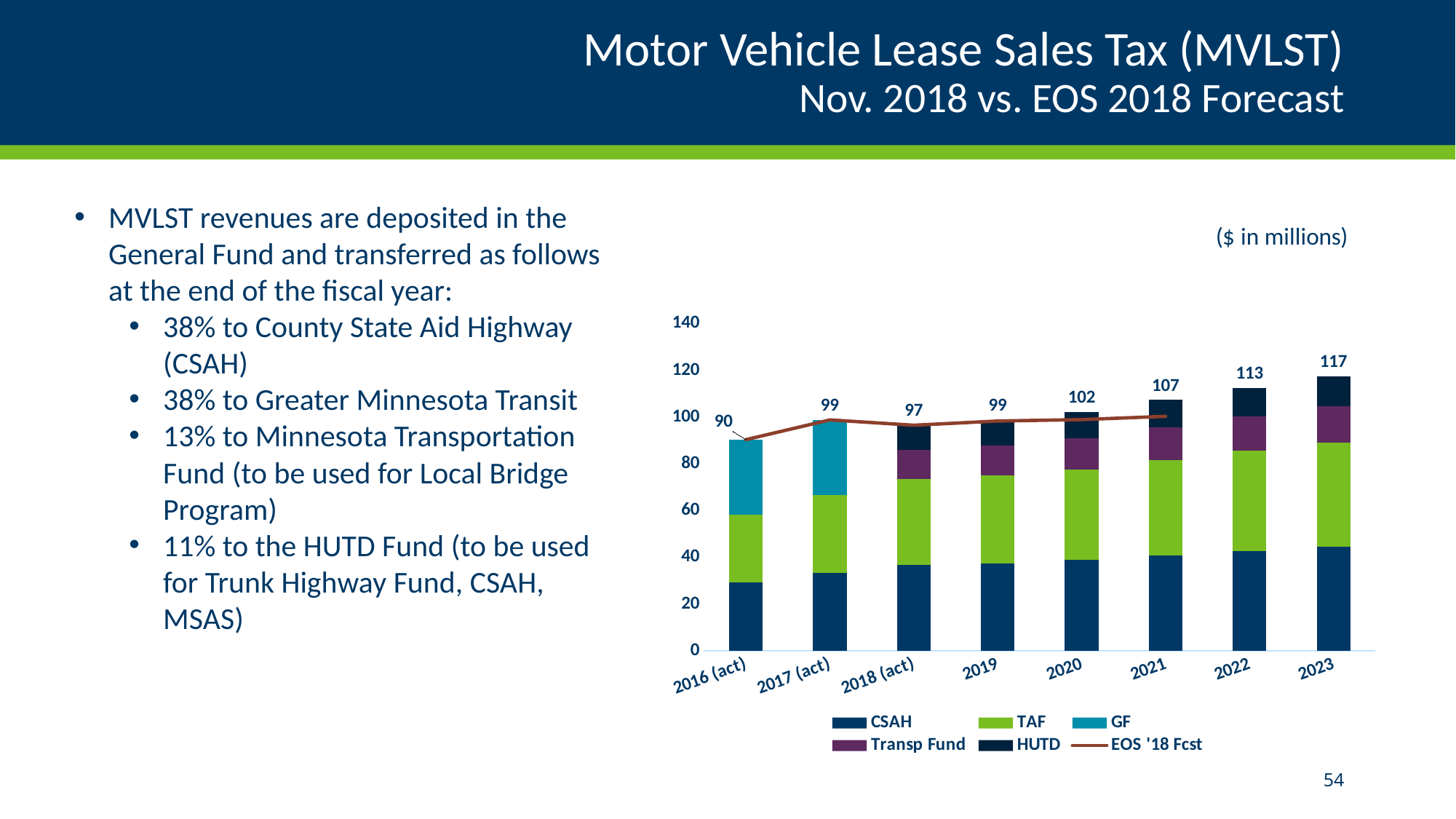
What is the total value shown for 2023? 117 Is the CSAH value for 2023 greater or less than 40? greater What kind of chart is shown on the slide? Stacked bar chart with a line How many entries does the legend list? 6 How many years are shown on the x axis? 8 Which year has the highest total value? 2023 What is the total value shown for 2016 (act)? 90 What is the total value shown for 2020? 102 What is the difference between the total for 2023 and the total for 2016 (act)? 27 Which year has the lowest total value? 2016 (act) Do the total values rise or fall from 2018 (act) to 2023? Rise Which is larger, the total for 2017 (act) or the total for 2018 (act)? 2017 (act)